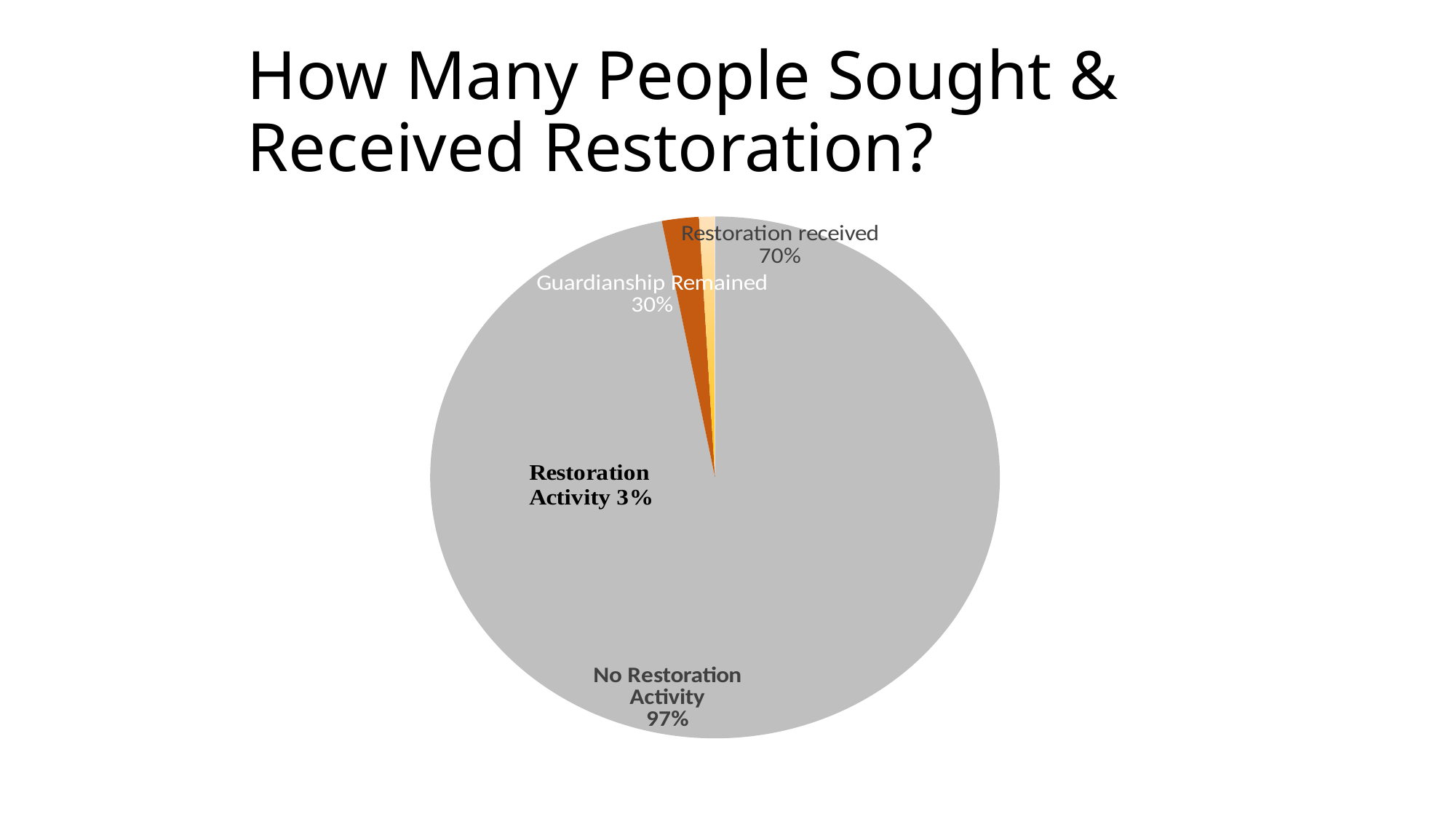
Which category has the largest slice of the pie? No Restoration Activity What percentage is shown for Restoration received? 70% What percentage is shown for Restoration Activity? 3% Is the share for No Restoration Activity greater or less than 90%? greater What is the title of the slide? How Many People Sought & Received Restoration? What is the difference in percentage points between No Restoration Activity (97%) and Restoration Activity (3%)? 94 percentage points Which is larger, the share for No Restoration Activity or the share for Restoration Activity? No Restoration Activity What percentage is shown for Guardianship Remained? 30% What kind of chart is shown on the slide? pie chart What colour is the No Restoration Activity slice? gray What percentage is shown for No Restoration Activity? 97%